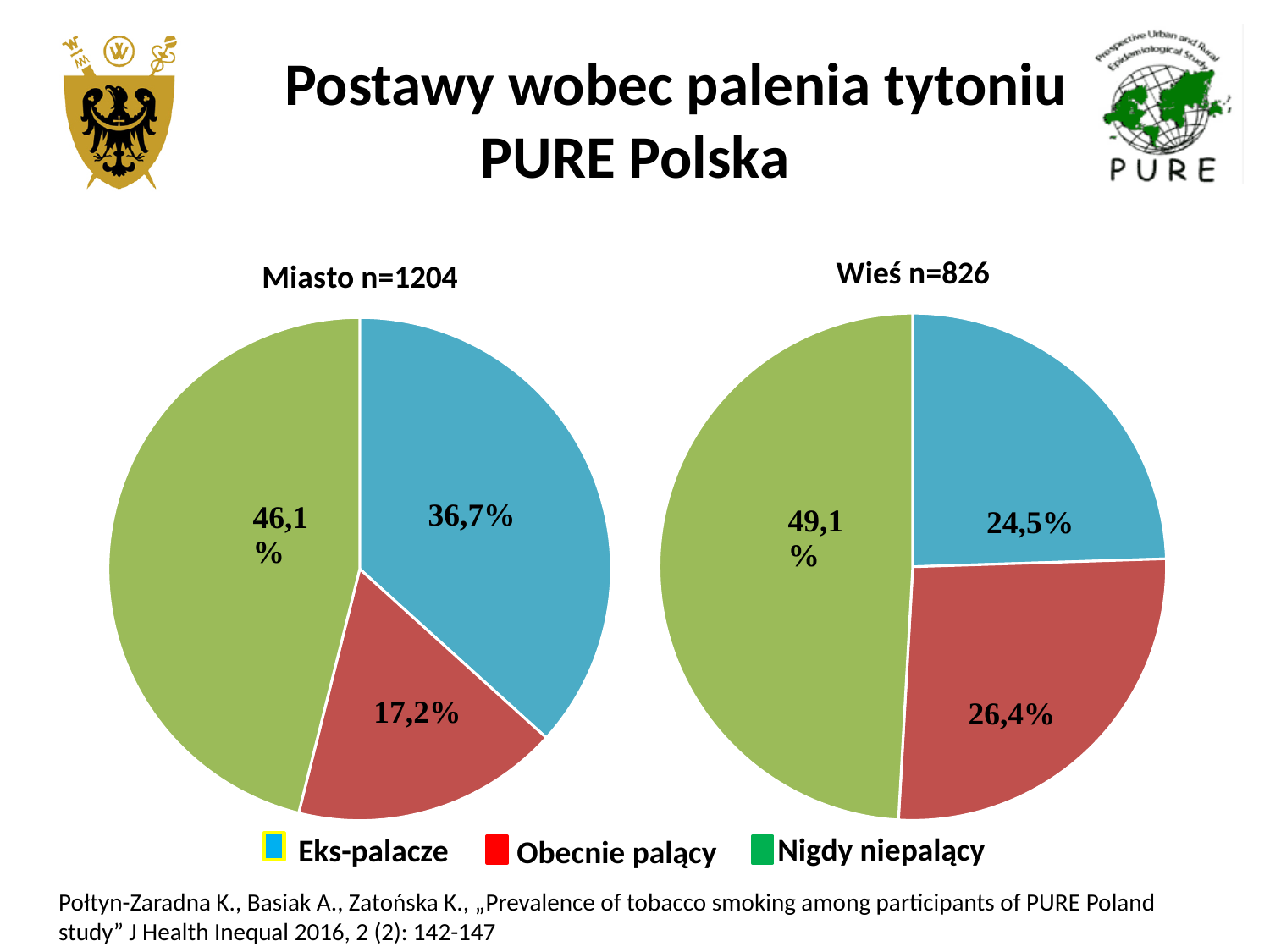
In the 'Wieś n=826' pie chart, what is the value for Nigdy niepalący? 49,1% Which is larger: the Obecnie palący share in the 'Miasto n=1204' chart or in the 'Wieś n=826' chart? Wieś n=826 In the 'Miasto n=1204' pie chart, what is the difference between the Eks-palacze and Obecnie palący shares? 19,5% In the 'Wieś n=826' pie chart, what is the value for Obecnie palący? 26,4% In the 'Miasto n=1204' pie chart, which category has the largest share? Nigdy niepalący In the 'Wieś n=826' pie chart, which category has the smallest share? Eks-palacze How many categories does the legend list? 3 Which colour represents Eks-palacze in the legend? Blue In the 'Miasto n=1204' pie chart, what is the value for Eks-palacze? 36,7% What type of chart is used on this slide? Pie chart In the 'Miasto n=1204' pie chart, what is the value for Obecnie palący? 17,2% How many slices does the 'Wieś n=826' pie chart have? 3